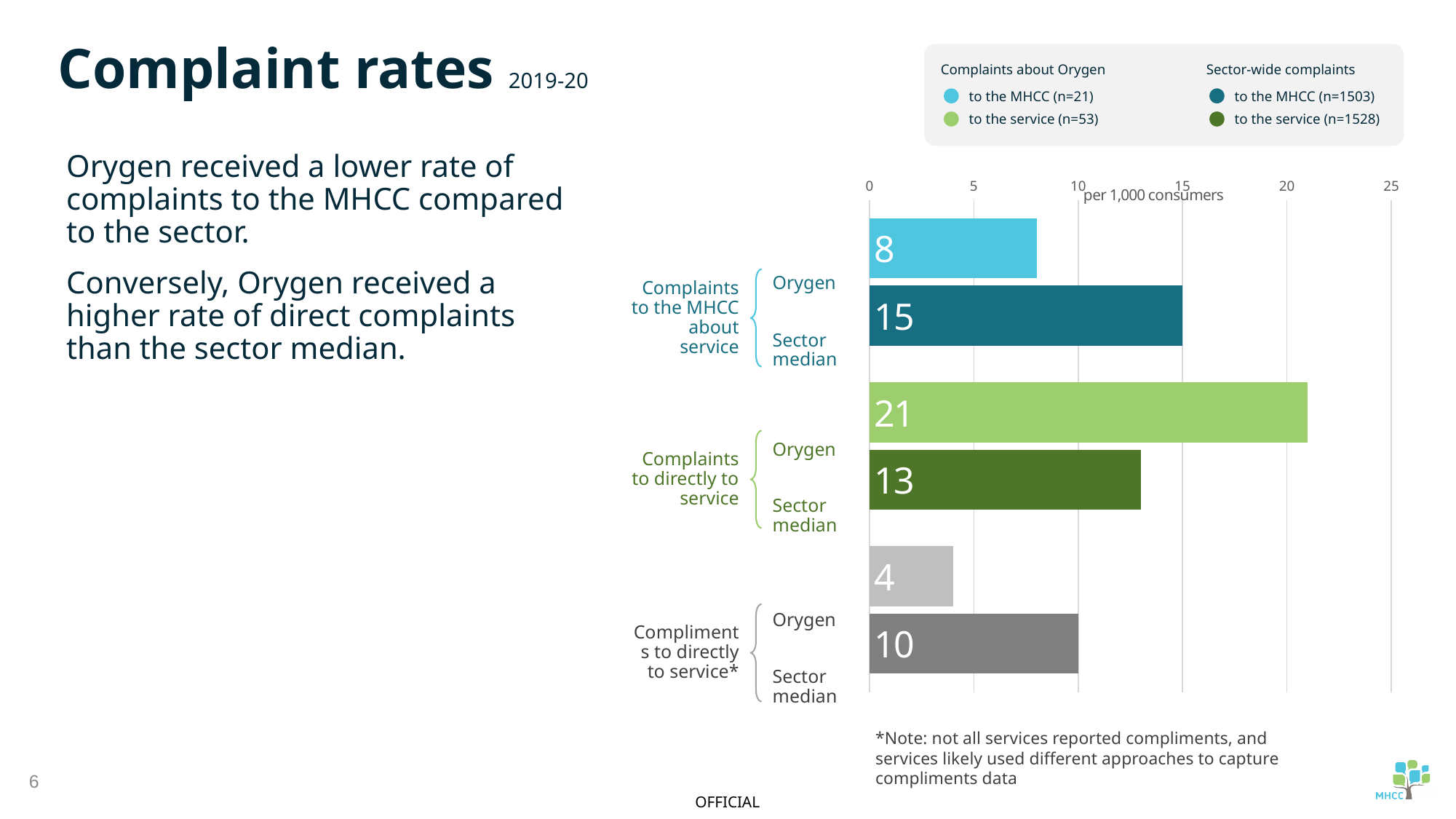
What is the value for Orygen for complaints to the MHCC about service? 8 What kind of chart is shown on the slide? Bar chart What is the difference between the Orygen value and the sector median for complaints directly to service? 8 What is the value for Orygen for complaints directly to service? 21 What is the sector median value for compliments directly to service? 10 What is the sector median value for complaints to the MHCC about service? 15 Which bar has the highest value on the chart? Orygen, complaints directly to service Which bar has the lowest value on the chart? Orygen, compliments directly to service What is the difference between the sector median and the Orygen value for complaints to the MHCC about service? 7 Which is larger for compliments directly to service: Orygen or the sector median? Sector median What unit is the x axis of the chart measured in? per 1,000 consumers How many bars are plotted on the chart? 6